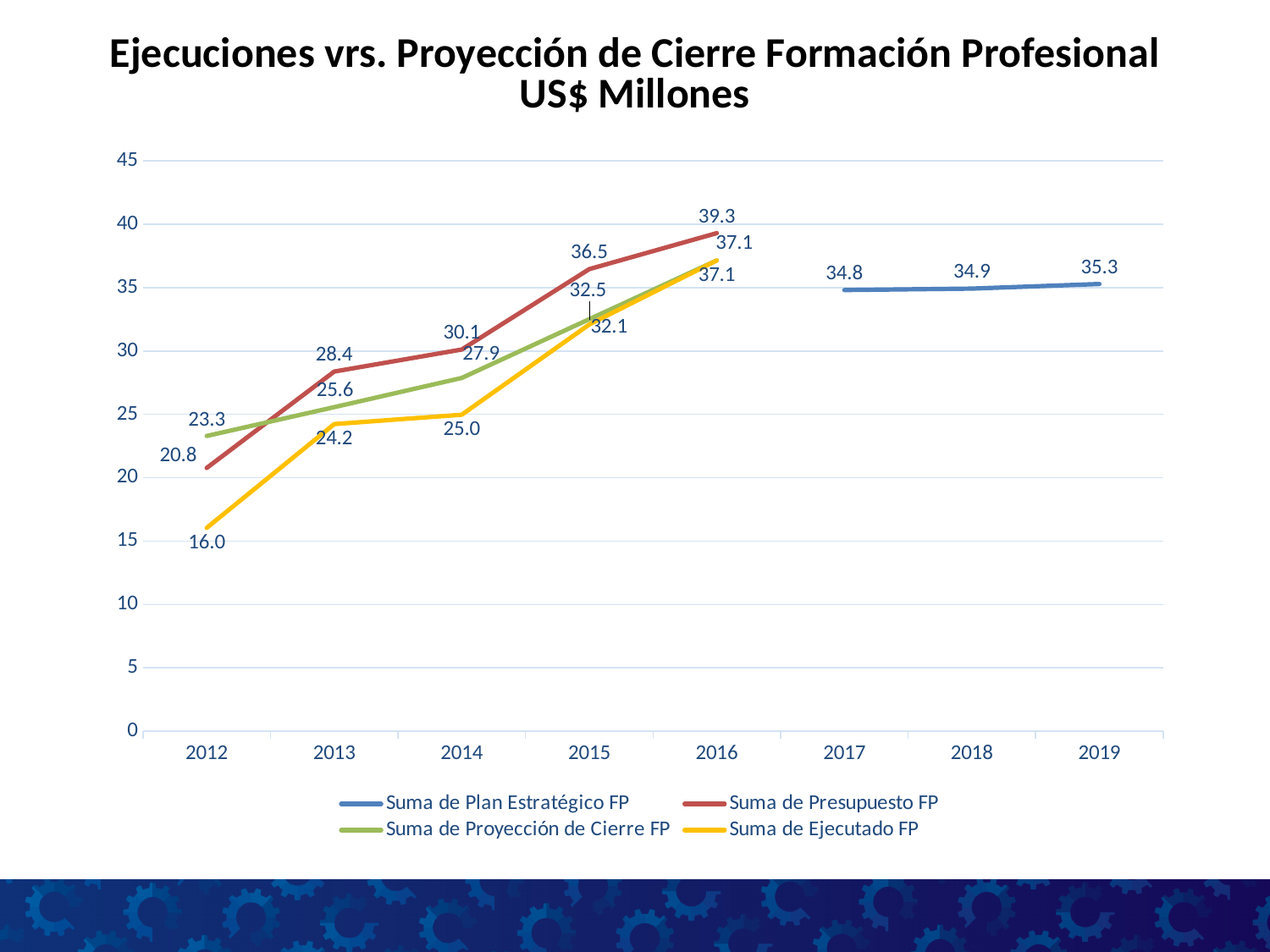
In 2013, which is larger: Suma de Presupuesto FP or Suma de Proyección de Cierre FP? Suma de Presupuesto FP What is the value of Suma de Ejecutado FP in 2012? 16.0 How many years are shown on the x axis? 8 What is the value of Suma de Plan Estratégico FP in 2019? 35.3 In which year does Suma de Presupuesto FP reach its highest value? 2016 What is the difference between Suma de Presupuesto FP and Suma de Ejecutado FP in 2016? 2.2 What kind of chart is shown on the slide? Line chart How many series does the legend list? 4 In which year is Suma de Ejecutado FP at its lowest? 2012 By how much did Suma de Ejecutado FP increase from 2012 to 2013? 8.2 What is the value of Suma de Presupuesto FP in 2016? 39.3 What is the value of Suma de Proyección de Cierre FP in 2014? 27.9